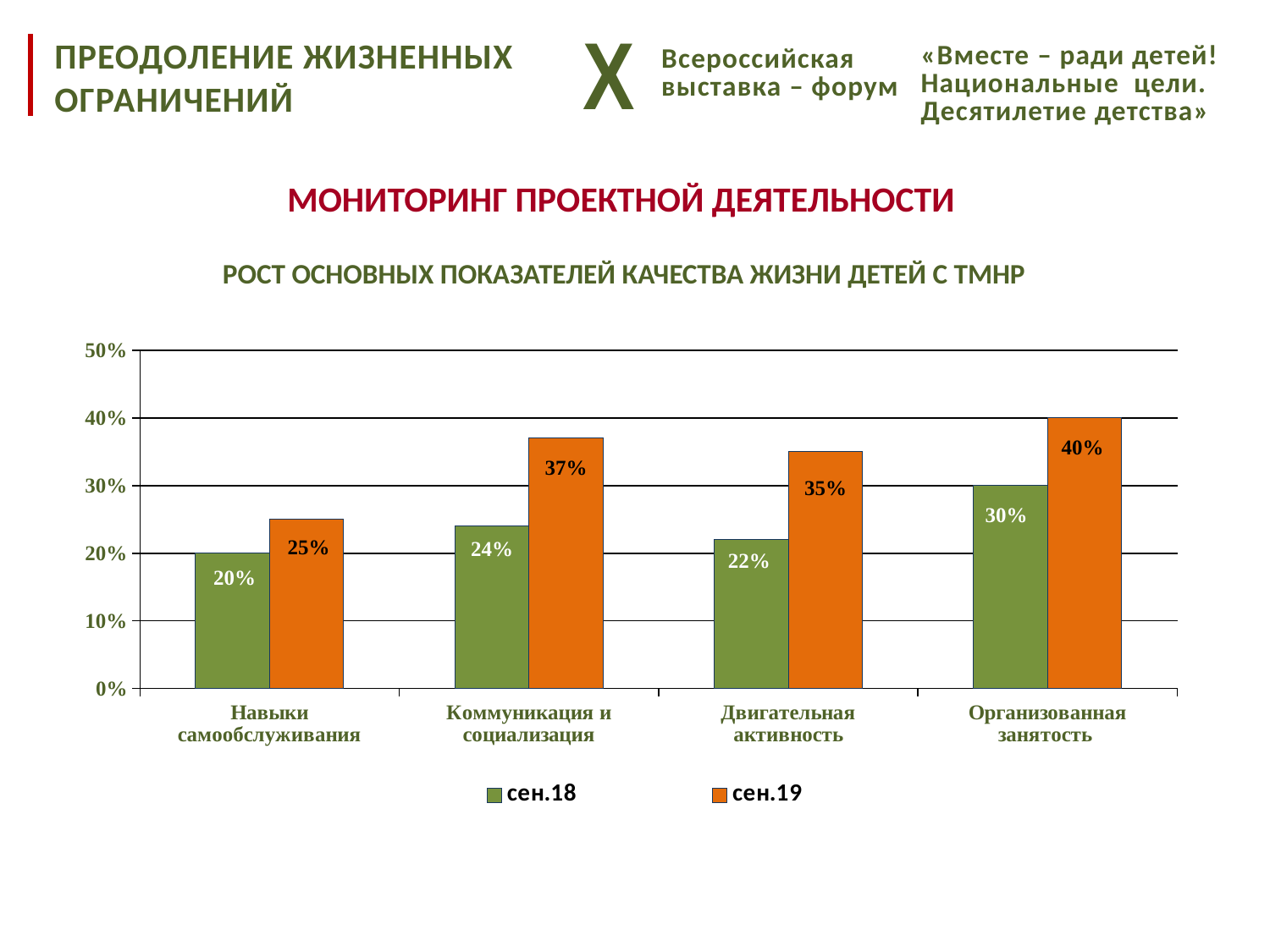
How many categories are shown on the x axis? 4 What is the difference between the сен.19 and сен.18 values for Коммуникация и социализация? 13% Which category has the highest value for сен.19? Организованная занятость Which category has the lowest value for сен.18? Навыки самообслуживания How many series does the legend list? 2 Which is larger: the сен.19 value for Двигательная активность or the сен.19 value for Организованная занятость? Организованная занятость What is the value for сен.19 in the Коммуникация и социализация category? 37% Which series is shown in orange in the legend? сен.19 What is the value for сен.18 in the Навыки самообслуживания category? 20% What is the value for сен.18 in the Двигательная активность category? 22% What is the value for сен.19 in the Организованная занятость category? 40% What kind of chart is shown on the slide? Bar chart